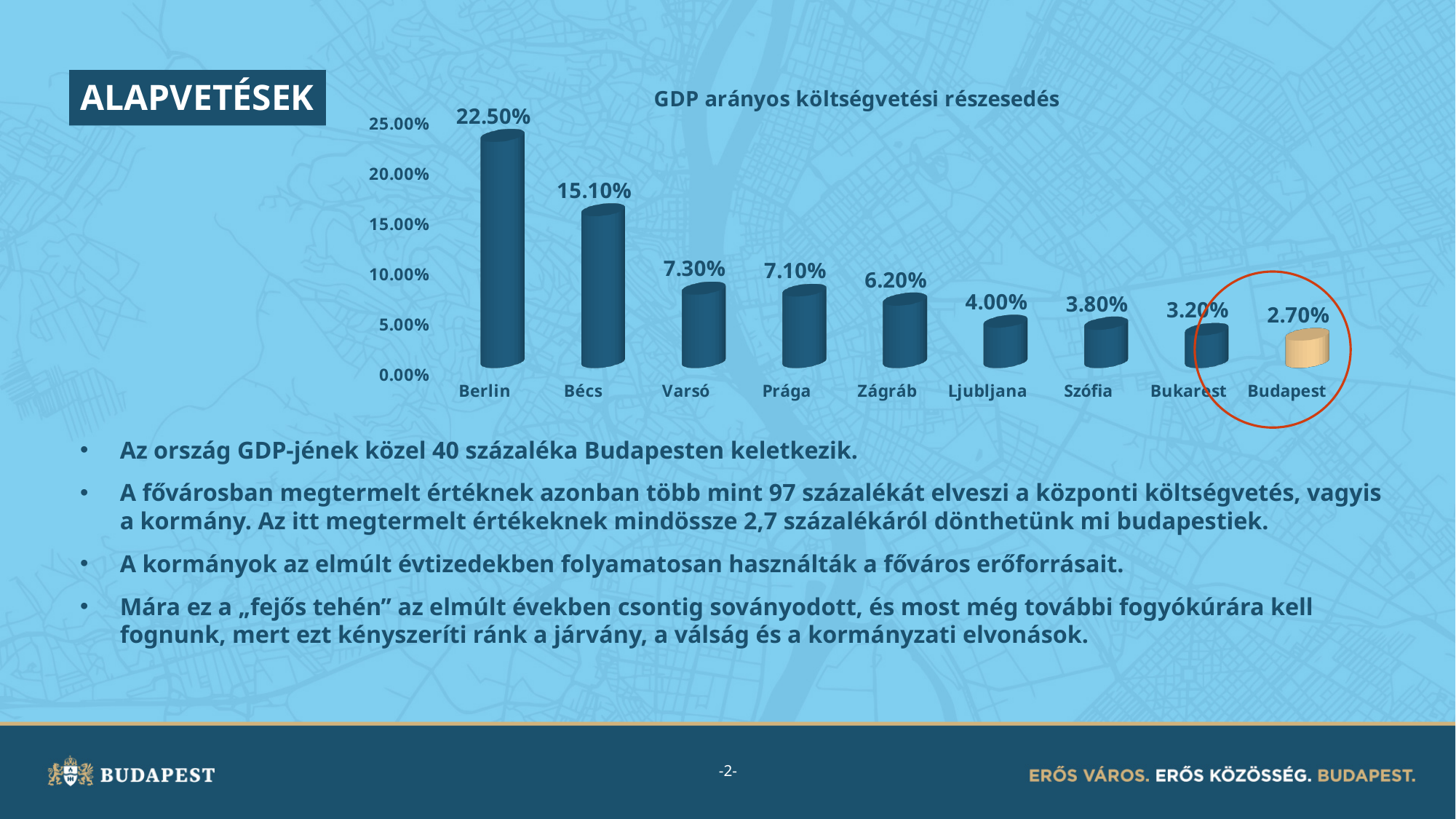
What is the value for Varsó? 7.30% What is the value for Berlin? 22.50% Which has a larger value, Zágráb or Ljubljana? Zágráb What is the difference between the values for Berlin and Bécs? 7.40% Which city has the lowest value? Budapest What is the title of the chart? GDP arányos költségvetési részesedés Which city has the highest value? Berlin Do the values rise or fall from left to right along the x axis? fall What is the value for Budapest? 2.70% Is the value for Bécs greater or less than 10.00%? greater What kind of chart is shown on the slide? bar chart How many cities are shown on the chart? 9